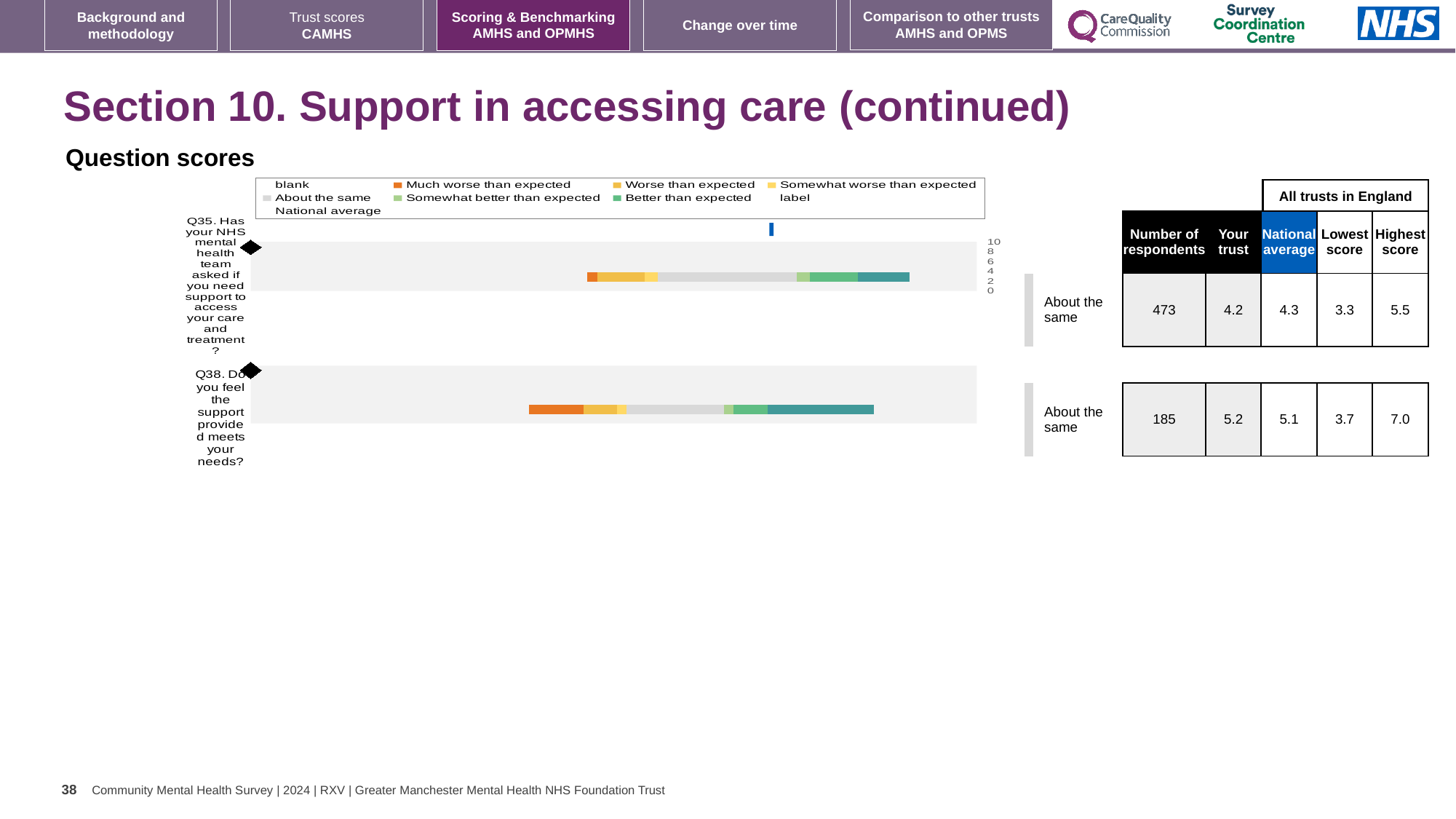
Is the 'Your trust' score for Q38 greater or less than the national average for Q38? greater What kind of chart is shown under 'Question scores'? bar chart How many entries does the chart legend list? 9 How many respondents answered Q35 according to the table beside the chart? 473 Which legend entry is shown in orange? Much worse than expected Which question has the larger number of respondents, Q35 or Q38? Q35 What benchmark category label is shown next to the bar for Q35? About the same How many survey questions are plotted as bars in the chart? 2 What is the difference between the highest and lowest scores for Q38? 3.3 What is the highest score across all trusts in England for Q38? 7.0 What is the 'Your trust' score for Q35 in the table beside the chart? 4.2 What is the national average score for Q38 in the table beside the chart? 5.1